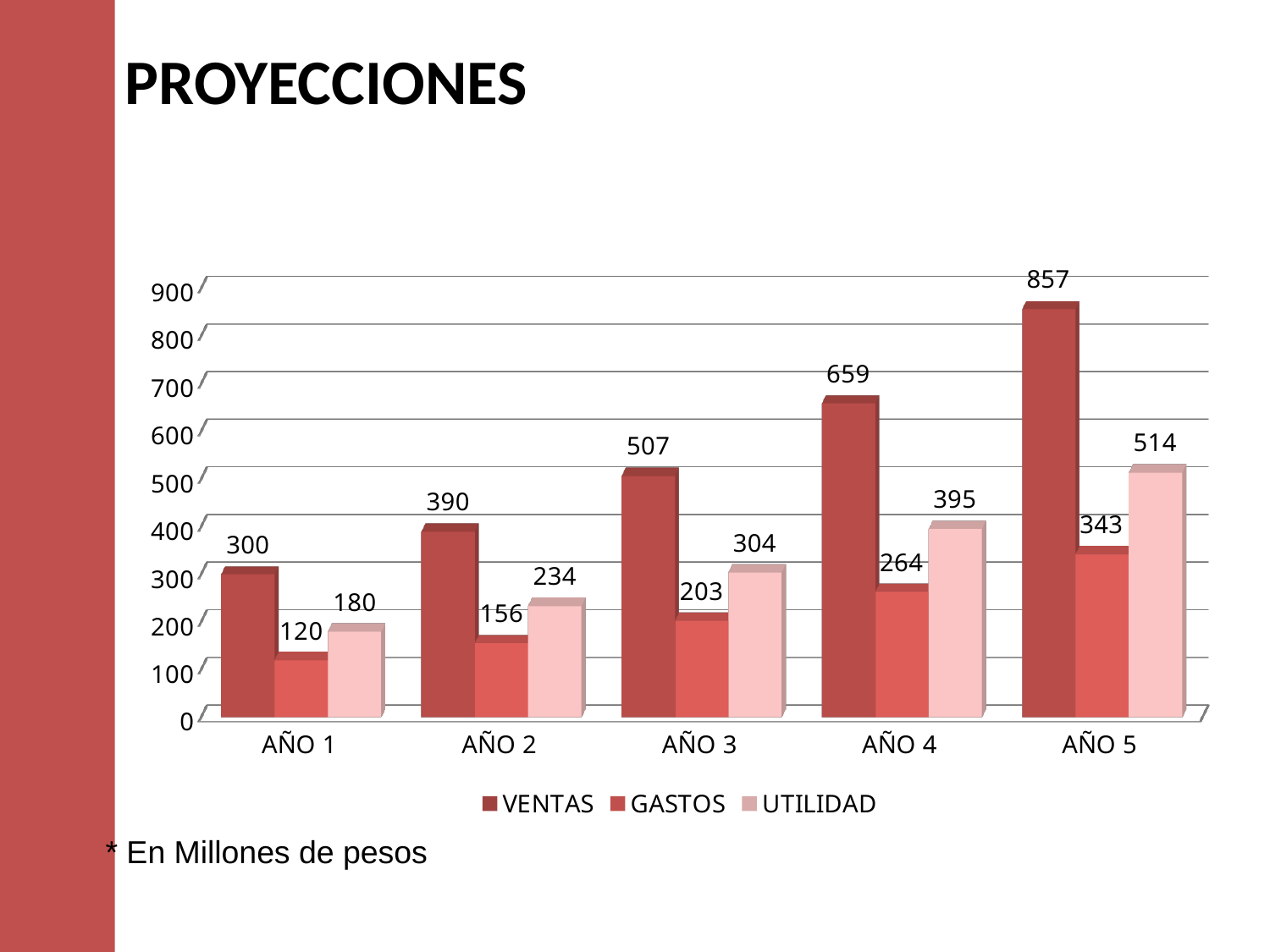
What is the UTILIDAD value for AÑO 1? 180 What is the difference between VENTAS and GASTOS in AÑO 4? 395 Is the VENTAS value for AÑO 5 greater or less than 800? greater Which is larger in AÑO 2: GASTOS or UTILIDAD? UTILIDAD Which year has the lowest GASTOS value? AÑO 1 What is the VENTAS value for AÑO 3? 507 Which year has the highest VENTAS value? AÑO 5 How many series does the legend list? 3 What kind of chart is shown on the slide? Bar chart Do the UTILIDAD values rise or fall from AÑO 1 to AÑO 5? Rise How many years are shown on the x axis? 5 What is the GASTOS value for AÑO 5? 343